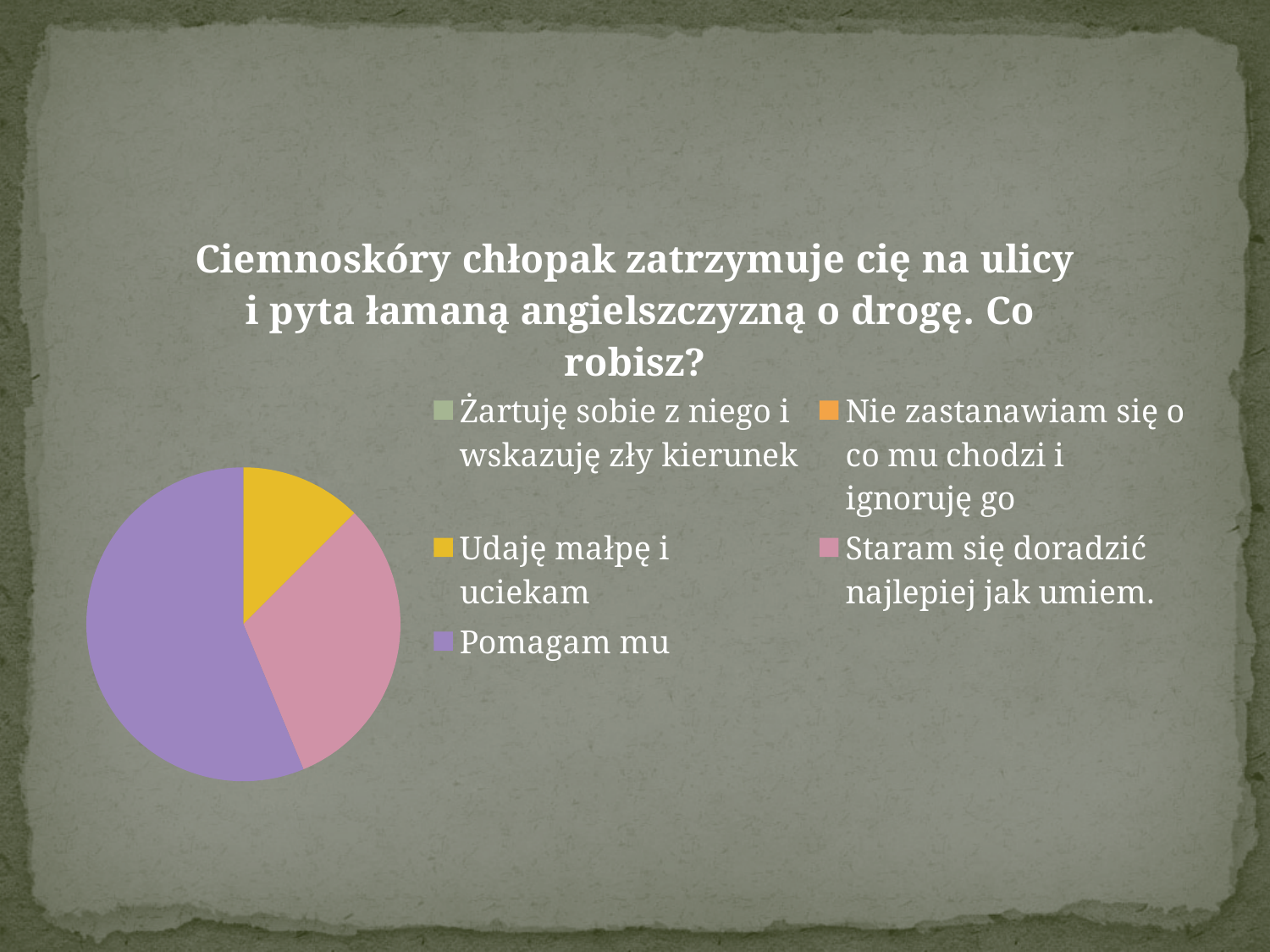
Which category has the largest slice of the pie? Pomagam mu What is the title of the chart? Ciemnoskóry chłopak zatrzymuje cię na ulicy i pyta łamaną angielszczyzną o drogę. Co robisz? How many slices are visible in the pie? 3 Which is larger: the slice for "Udaję małpę i uciekam" or the slice for "Staram się doradzić najlepiej jak umiem."? Staram się doradzić najlepiej jak umiem. Which is larger: the slice for "Pomagam mu" or the slice for "Staram się doradzić najlepiej jak umiem."? Pomagam mu How many entries does the legend list? 5 What colour is the slice for "Pomagam mu"? purple Which is smaller: the slice for "Udaję małpę i uciekam" or the slice for "Pomagam mu"? Udaję małpę i uciekam What kind of chart is shown on the slide? pie chart